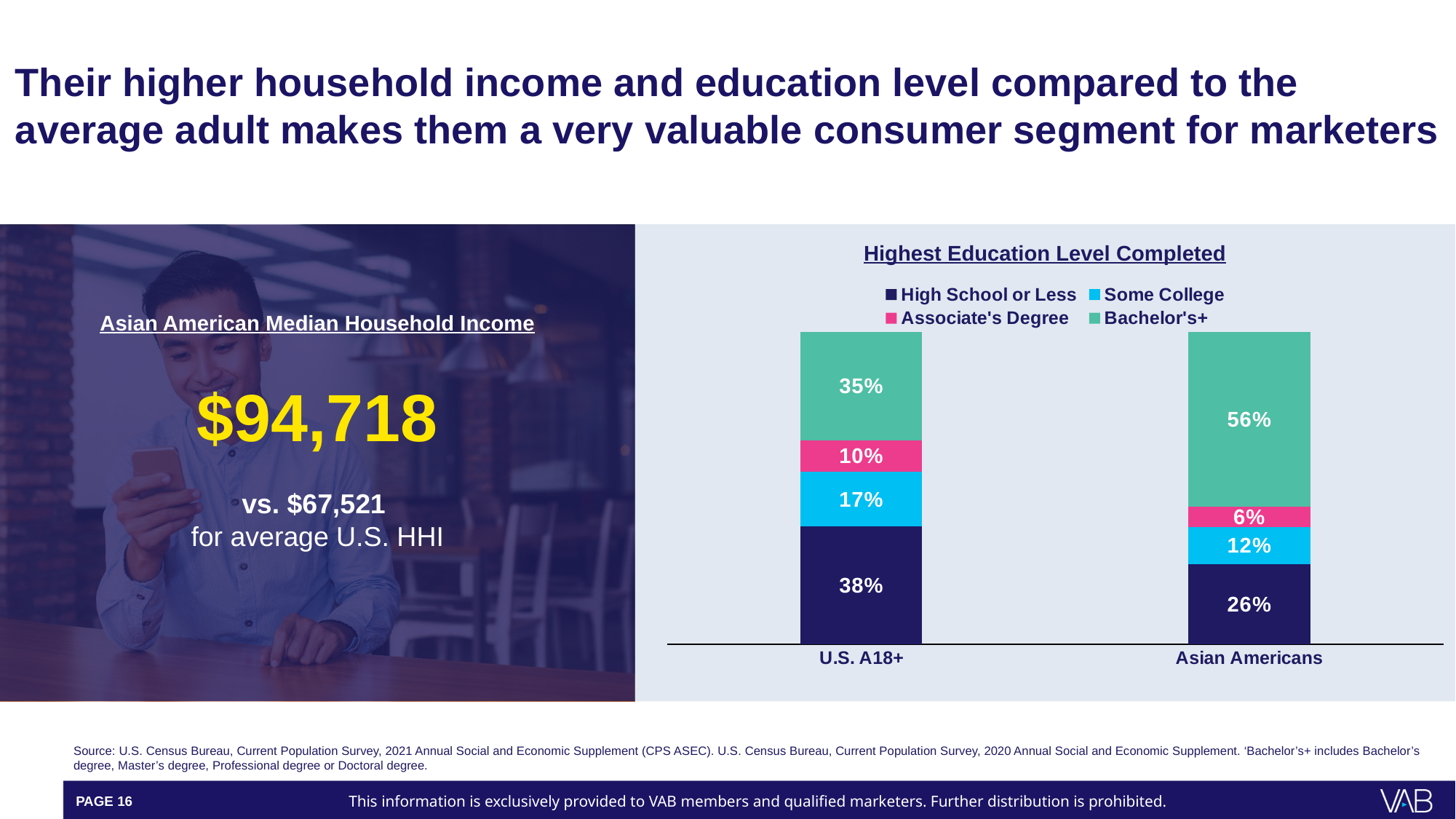
What is the Associate's Degree value for U.S. A18+? 10% What is the Some College value for Asian Americans? 12% How many series does the legend of the "Highest Education Level Completed" chart list? 4 Which education level is the smallest segment in the Asian Americans bar? Associate's Degree What is the High School or Less value for U.S. A18+? 38% How many categories are shown on the x axis of the "Highest Education Level Completed" chart? 2 What is the Bachelor's+ value for Asian Americans? 56% What is the difference between the Bachelor's+ values for Asian Americans and U.S. A18+? 21% What kind of chart is shown under the title "Highest Education Level Completed"? Stacked bar chart What is the difference between the High School or Less values for U.S. A18+ and Asian Americans? 12% Which education level is the largest segment in the U.S. A18+ bar? High School or Less Which category has the higher Bachelor's+ value, U.S. A18+ or Asian Americans? Asian Americans